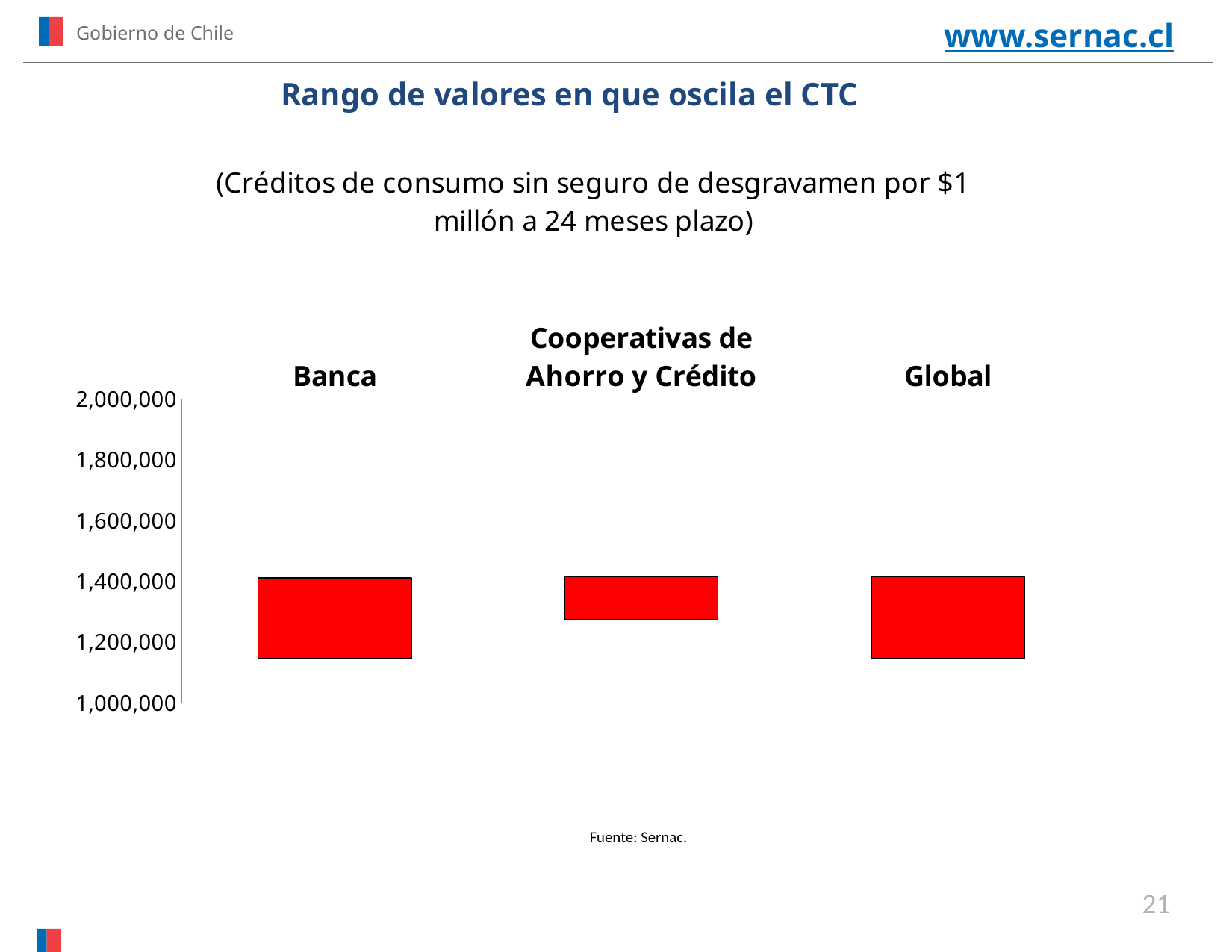
Which category has the highest lower bound of its range? Cooperativas de Ahorro y Crédito Is the lower end of the range for Banca greater or less than 1,200,000? less Is the upper end of the range for Banca greater or less than 1,200,000? greater What kind of chart is shown on the slide? bar chart What is the lowest value shown on the vertical axis? 1,000,000 How many categories are shown on the chart? 3 Is the lower end of the range for Cooperativas de Ahorro y Crédito higher or lower than the lower end of the range for Banca? higher What is the title of the chart on the slide? (Créditos de consumo sin seguro de desgravamen por $1 millón a 24 meses plazo) Which category has the narrowest range of values? Cooperativas de Ahorro y Crédito Is the lower end of the range for Cooperativas de Ahorro y Crédito greater or less than 1,200,000? greater